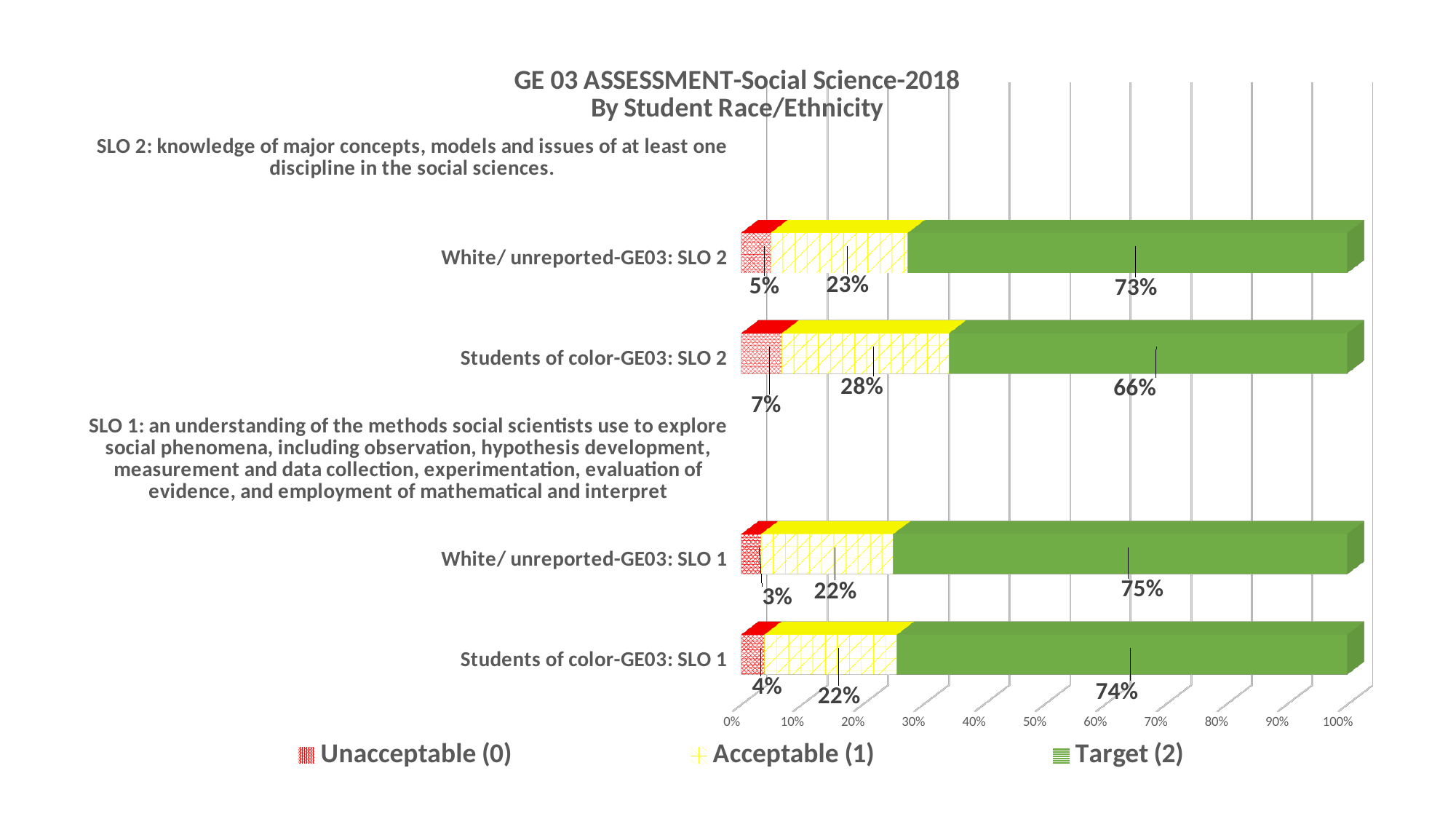
How many series does the legend list? 3 What kind of chart is shown on the slide? Stacked bar chart Which is larger: the Unacceptable (0) value for Students of color-GE03: SLO 2 or for White/ unreported-GE03: SLO 1? Students of color-GE03: SLO 2 What is the Target (2) value for White/ unreported-GE03: SLO 1? 75% What is the Target (2) value for Students of color-GE03: SLO 1? 74% What is the difference between the Target (2) values for White/ unreported-GE03: SLO 2 and Students of color-GE03: SLO 2? 7% Which category has the highest Target (2) value? White/ unreported-GE03: SLO 1 How many categories are shown on the chart? 4 What is the title of the chart? GE 03 ASSESSMENT-Social Science-2018 By Student Race/Ethnicity What is the Acceptable (1) value for Students of color-GE03: SLO 2? 28% Which category has the lowest Target (2) value? Students of color-GE03: SLO 2 What is the Unacceptable (0) value for White/ unreported-GE03: SLO 2? 5%